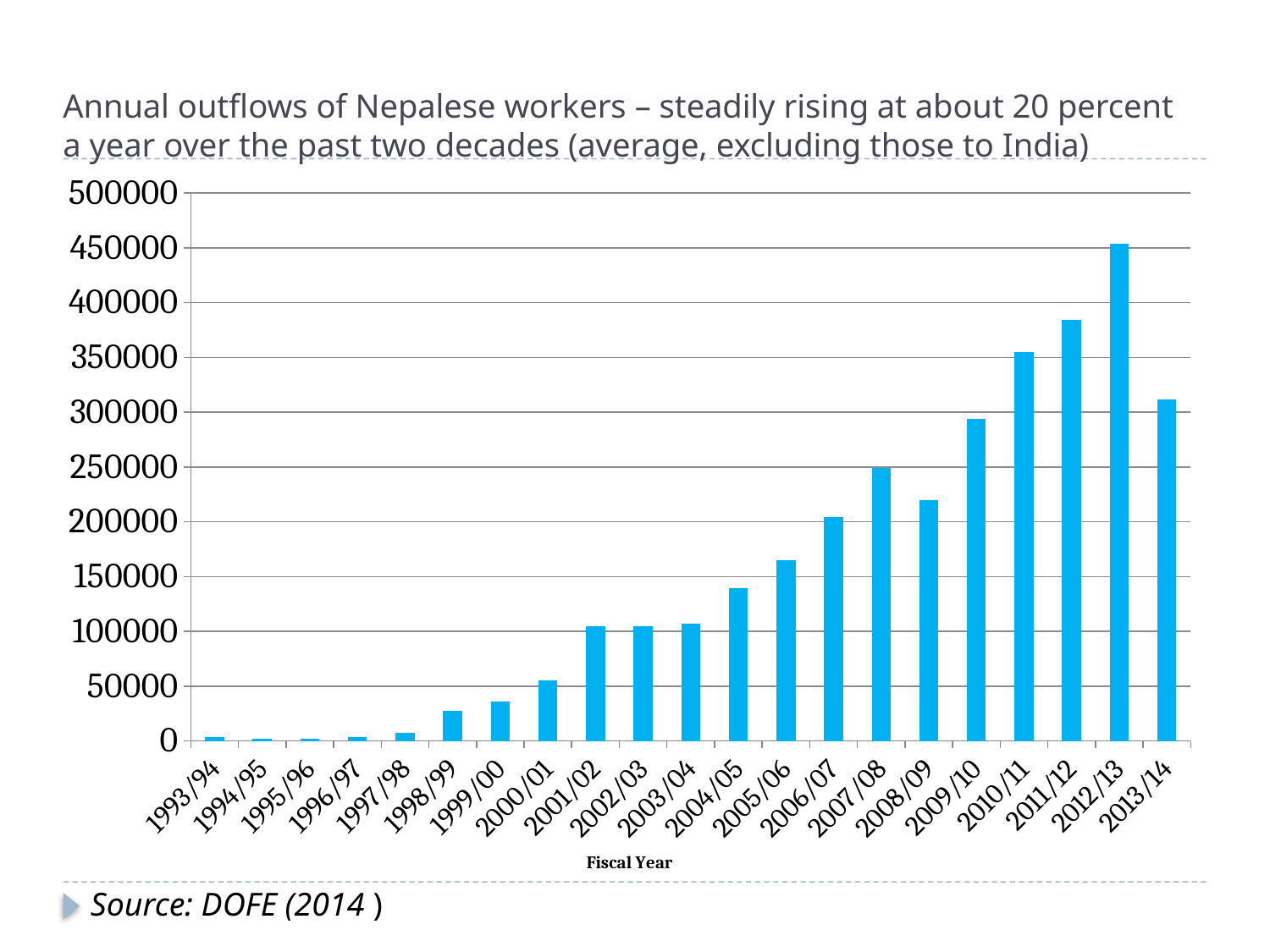
Is the value for 1999/00 greater or less than 50000? less Is the value for 2013/14 greater or less than 300000? greater Which fiscal year has the highest annual outflow of Nepalese workers? 2012/13 Which is larger, the value for 2012/13 or the value for 2013/14? 2012/13 Is the value for 2004/05 greater or less than 150000? less Do the values generally rise or fall from 1993/94 to 2012/13? Rise How many fiscal years are plotted on the chart? 21 What kind of chart is shown on the slide? Bar chart What is the title of the x axis? Fiscal Year